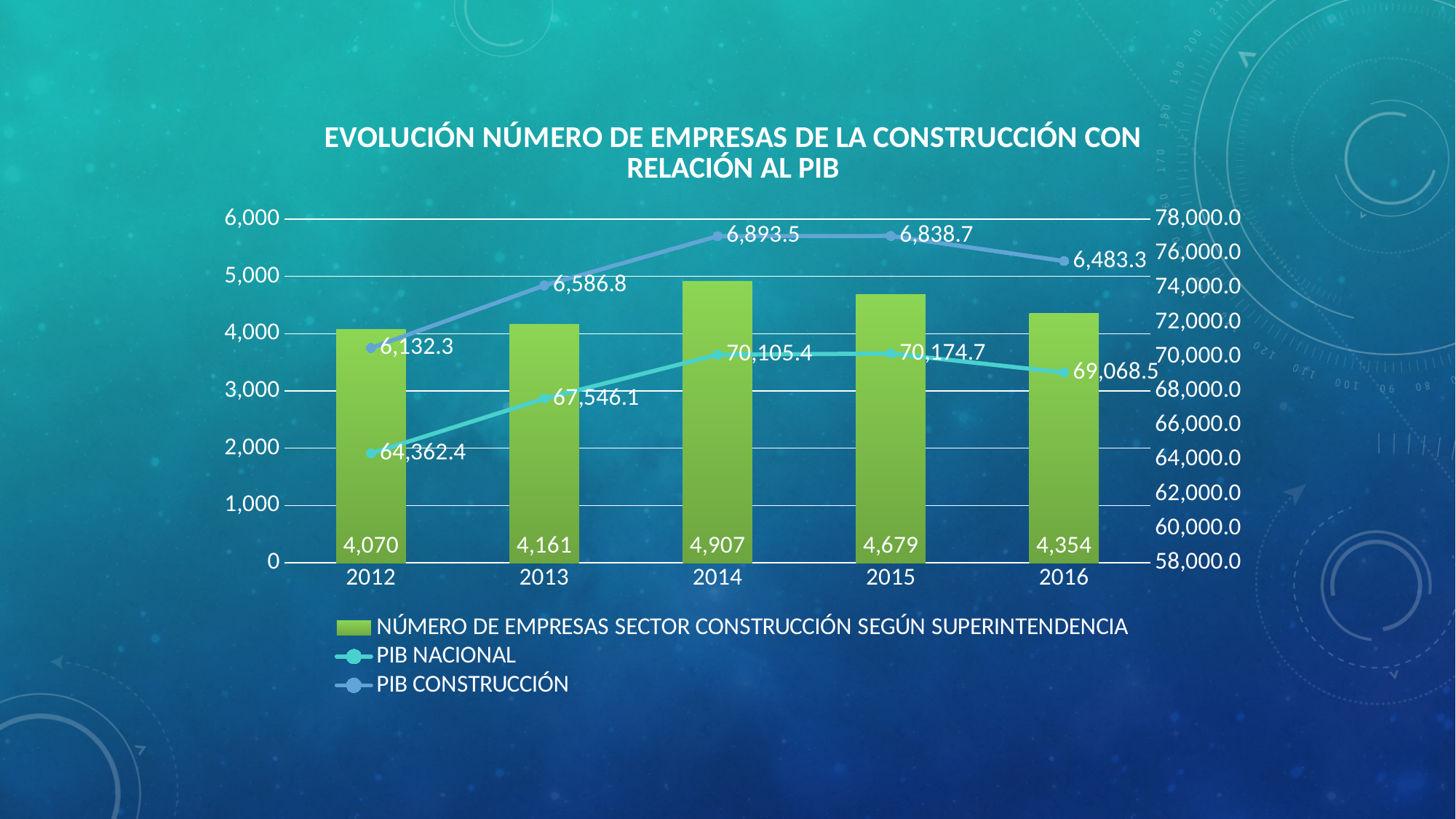
Is the number of construction companies in 2015 greater or less than 4,000? greater What is the difference in the number of construction companies between 2014 and 2016? 553 Which year has a higher PIB NACIONAL value, 2013 or 2015? 2015 How many series does the legend list? 3 How many years are shown on the x axis? 5 In which year is the PIB CONSTRUCCIÓN value lowest? 2012 In which year is the number of construction companies highest? 2014 Does the PIB NACIONAL line rise or fall from 2012 to 2014? rise What is the PIB CONSTRUCCIÓN value for 2016? 6,483.3 What is the number of construction companies (NÚMERO DE EMPRESAS SECTOR CONSTRUCCIÓN SEGÚN SUPERINTENDENCIA) in 2014? 4,907 What is the PIB NACIONAL value for 2012? 64,362.4 What kind of chart is this? Combined bar and line chart